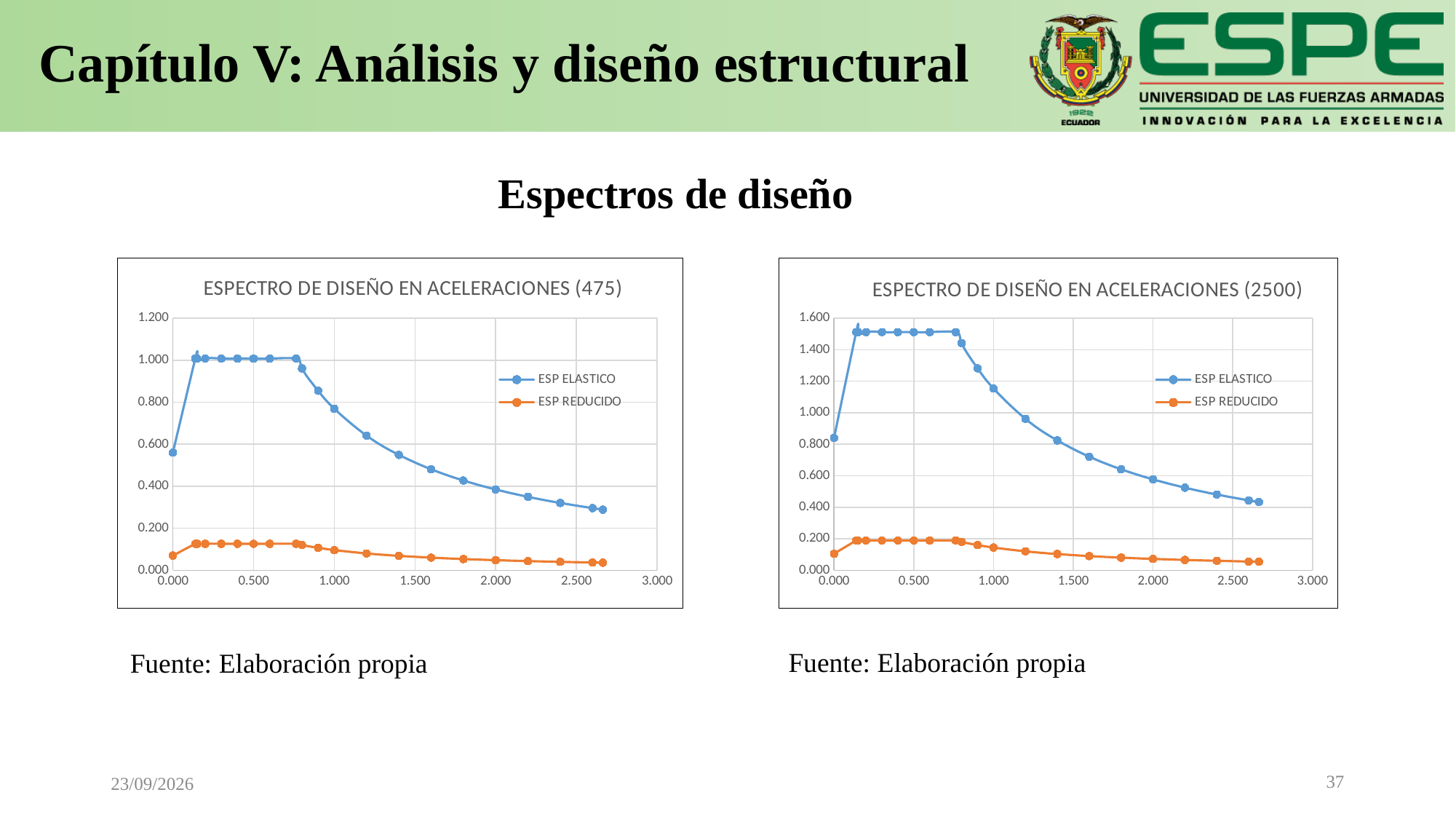
How many series does the legend of the right chart, ESPECTRO DE DISEÑO EN ACELERACIONES (2500), list? 2 What is the title of the right chart? ESPECTRO DE DISEÑO EN ACELERACIONES (2500) In the left chart (475), which series is plotted in orange? ESP REDUCIDO In the right chart (2500), does the ESP ELASTICO series rise or fall between 1.000 and 2.500 on the x axis? Fall In the right chart (2500), is the value of ESP ELASTICO at 0.000 greater or less than 0.600? greater In the left chart (475), is the value of ESP ELASTICO at 2.500 greater or less than 0.400? less In the right chart (2500), is the plateau value of ESP ELASTICO greater or less than 1.400? greater What kind of chart is the left chart, ESPECTRO DE DISEÑO EN ACELERACIONES (475)? Line chart In the left chart (475), which series has the larger value at 1.000: ESP ELASTICO or ESP REDUCIDO? ESP ELASTICO